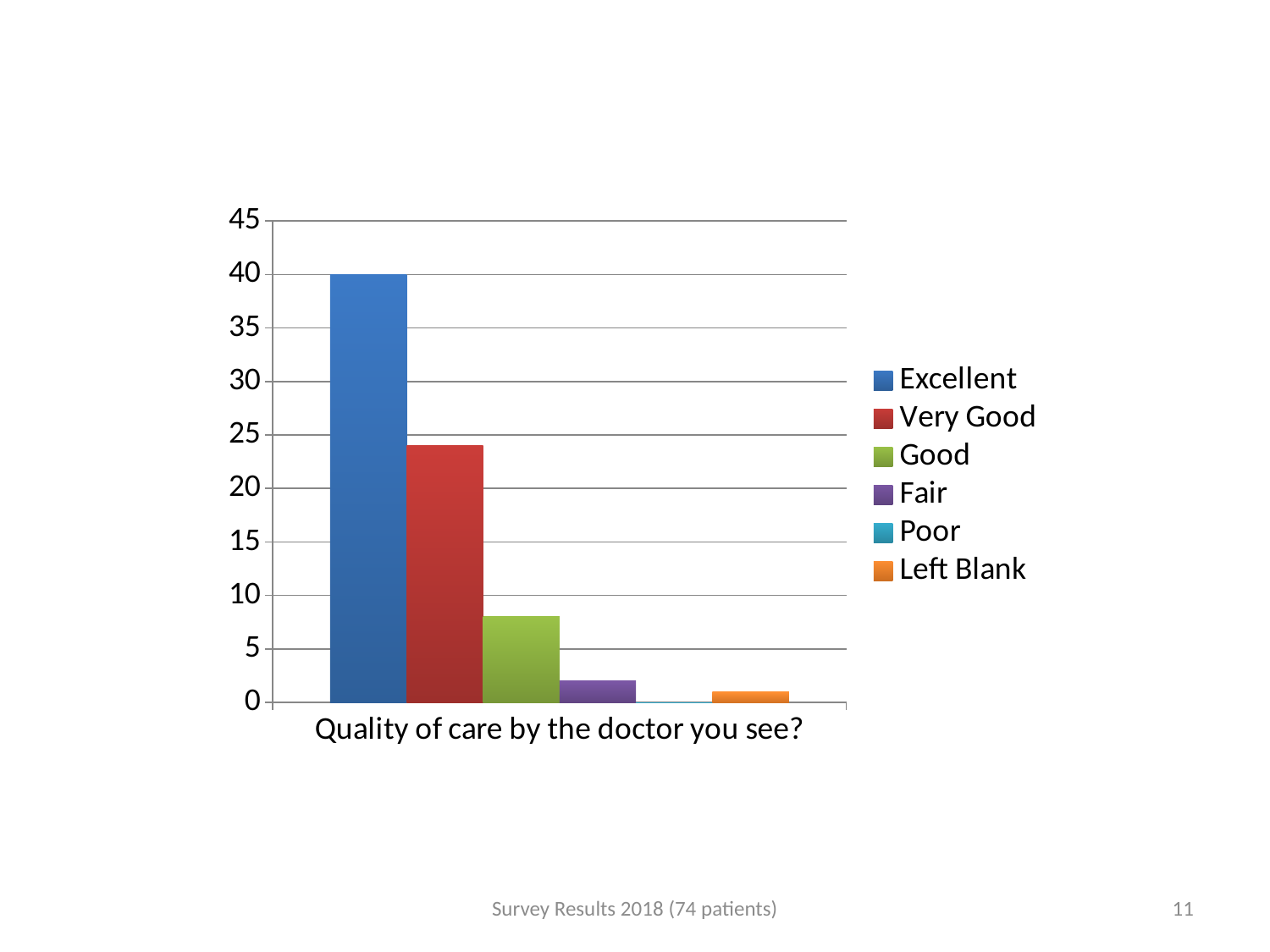
How many series does the legend list? 6 Is the value for Very Good greater or less than 20? greater Is the value for Good greater or less than 10? less Which legend entry is shown in orange? Left Blank Is the value for Very Good greater or less than 25? less What question is shown as the category label below the bars? Quality of care by the doctor you see? Which response has the highest bar? Excellent What kind of chart is shown on the slide? bar chart What is the value for Excellent? 40 Which response has the lowest bar? Poor Which is larger, the value for Very Good or the value for Good? Very Good